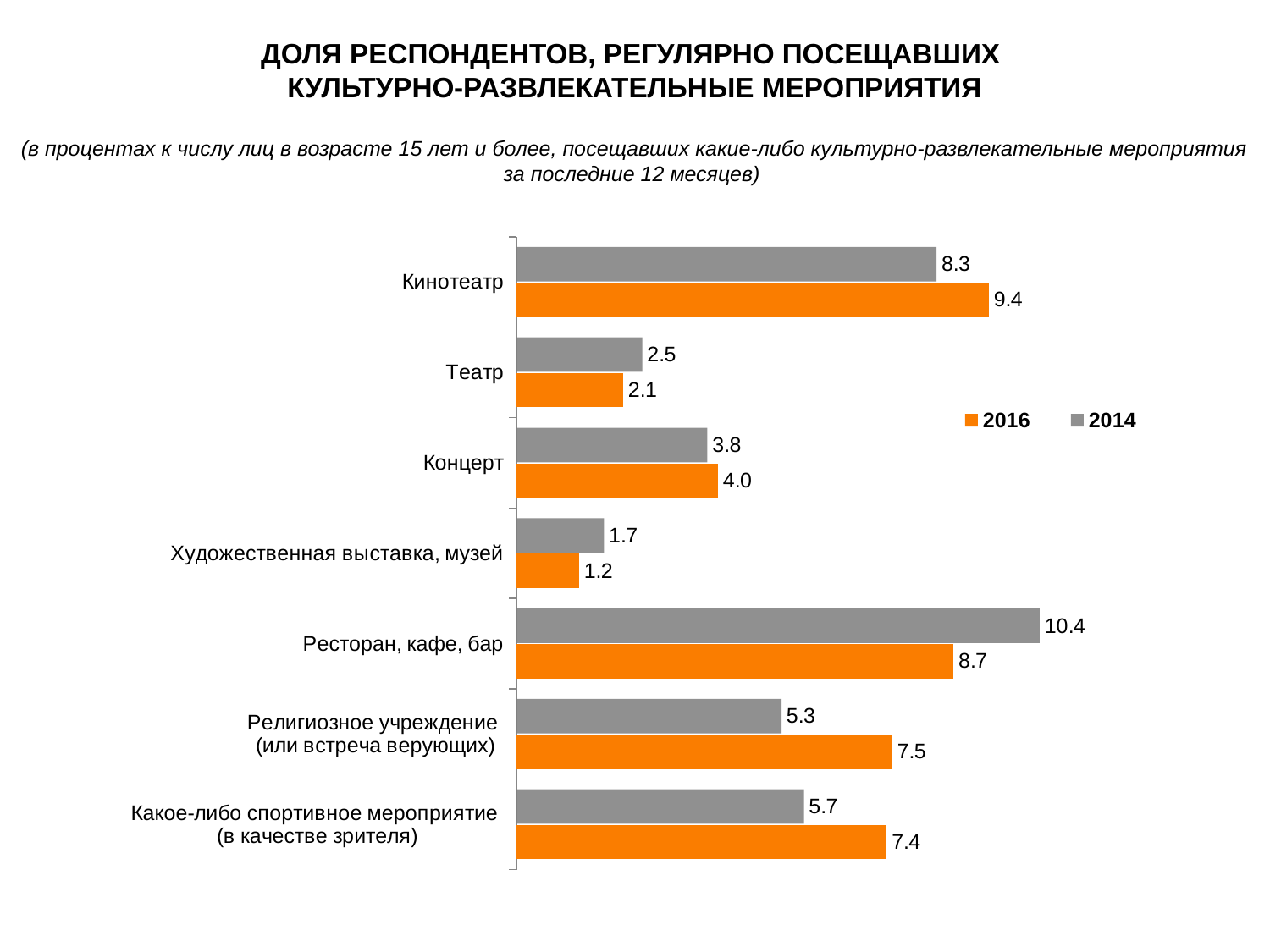
Which colour represents the 2016 series? Orange For Театр, which year has the larger value, 2014 or 2016? 2014 Which category has the highest 2014 value? Ресторан, кафе, бар What kind of chart is shown on the slide? Bar chart What is the 2016 value for Религиозное учреждение (или встреча верующих)? 7.5 What is the difference between the 2016 and 2014 values for Какое-либо спортивное мероприятие (в качестве зрителя)? 1.7 Which category has the lowest 2016 value? Художественная выставка, музей For Концерт, which year has the larger value, 2014 or 2016? 2016 How many series does the legend list? 2 What is the 2016 value for Кинотеатр? 9.4 What is the 2014 value for Ресторан, кафе, бар? 10.4 How many categories are shown on the chart? 7